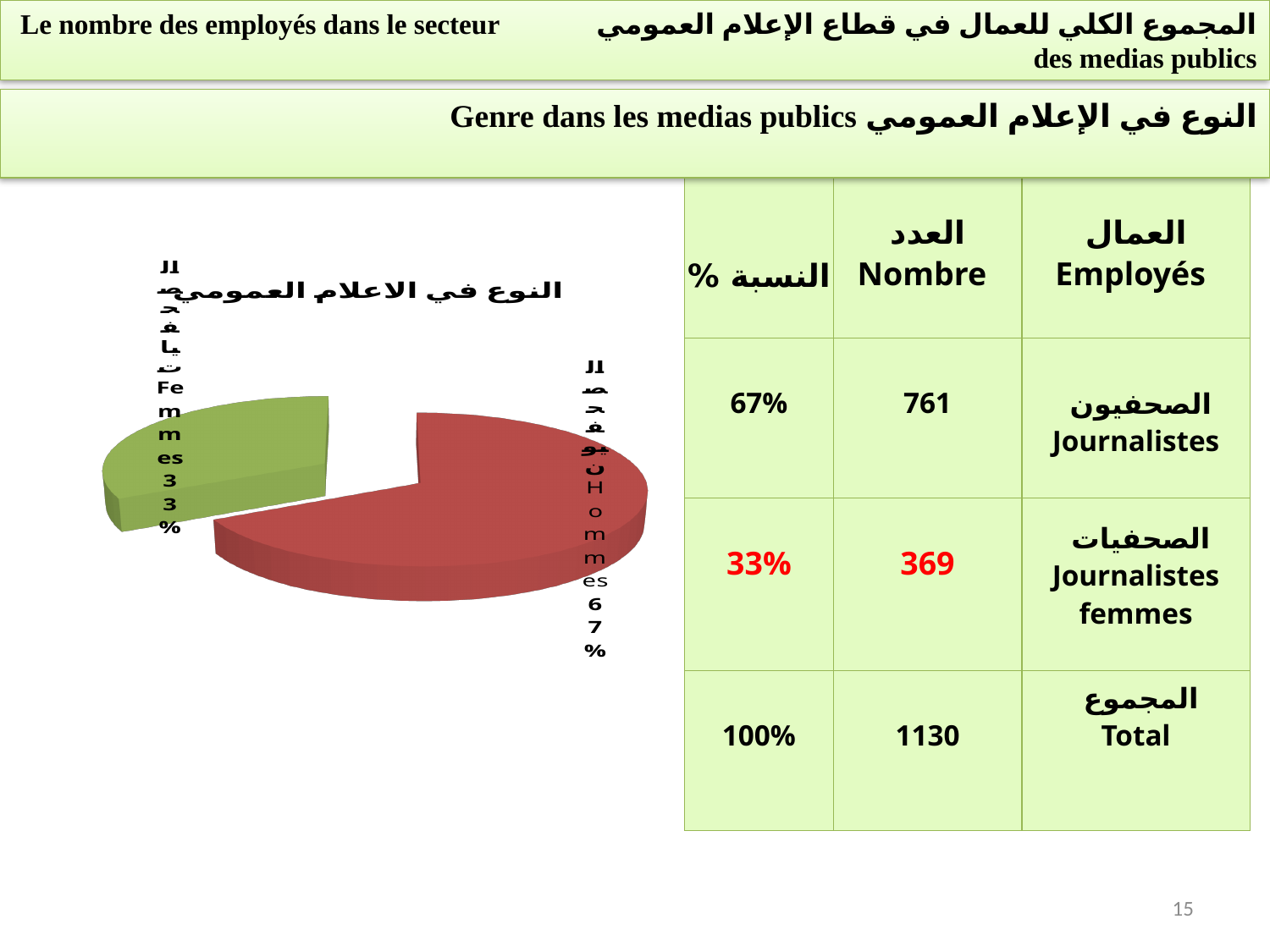
What is the difference in percentage points between the Hommes slice and the Femmes slice? 34% Which slice of the pie chart is the largest? Hommes Which is larger in the pie chart, the Hommes slice or the Femmes slice? Hommes What colour is the Femmes slice in the pie chart? green What kind of chart is shown on the slide? pie chart What share of the pie does the Hommes slice represent? 67% How many slices does the pie chart have? 2 What colour is the Hommes slice in the pie chart? red What share of the pie does the Femmes slice represent? 33% Which slice of the pie chart is the smallest? Femmes Is the share for Femmes greater or less than 50%? less